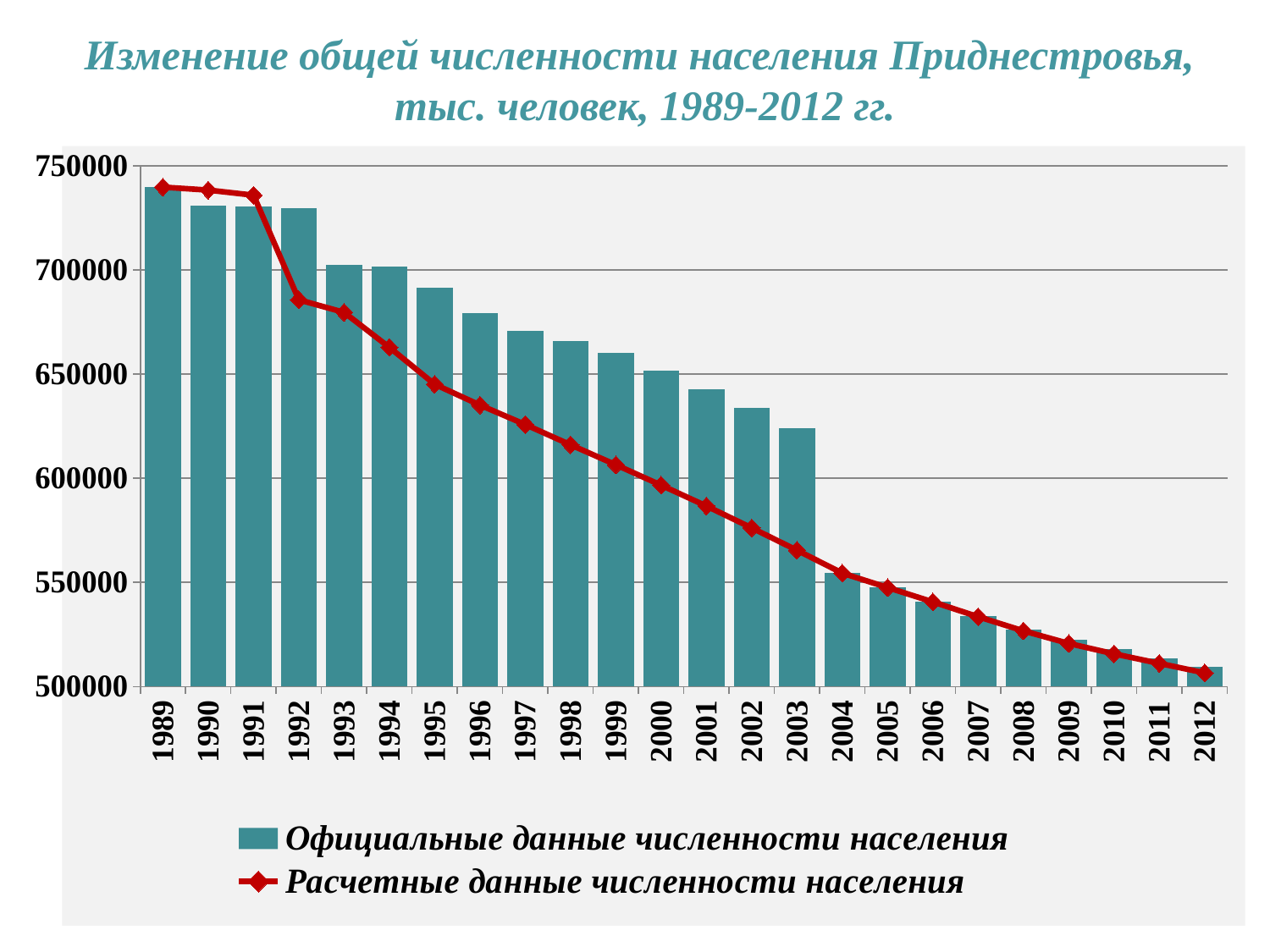
What colour are the bars for official population data? Teal Is the official population value for 1989 greater or less than 700000? greater Is the calculated population value (red line) for 1992 greater or less than 700000? less Is the calculated population value (red line) for 2001 greater or less than 600000? less Which year has the highest bar for official population data? 1989 In 2003, which is larger: the official population value (bar) or the calculated population value (line)? The official population value (bar) How many series does the legend list? 2 Which year has the lowest bar for official population data? 2012 Do the official population values rise or fall from 1989 to 2012? Fall What kind of chart is shown on the slide? A combined bar and line chart How many years are shown along the x axis? 24